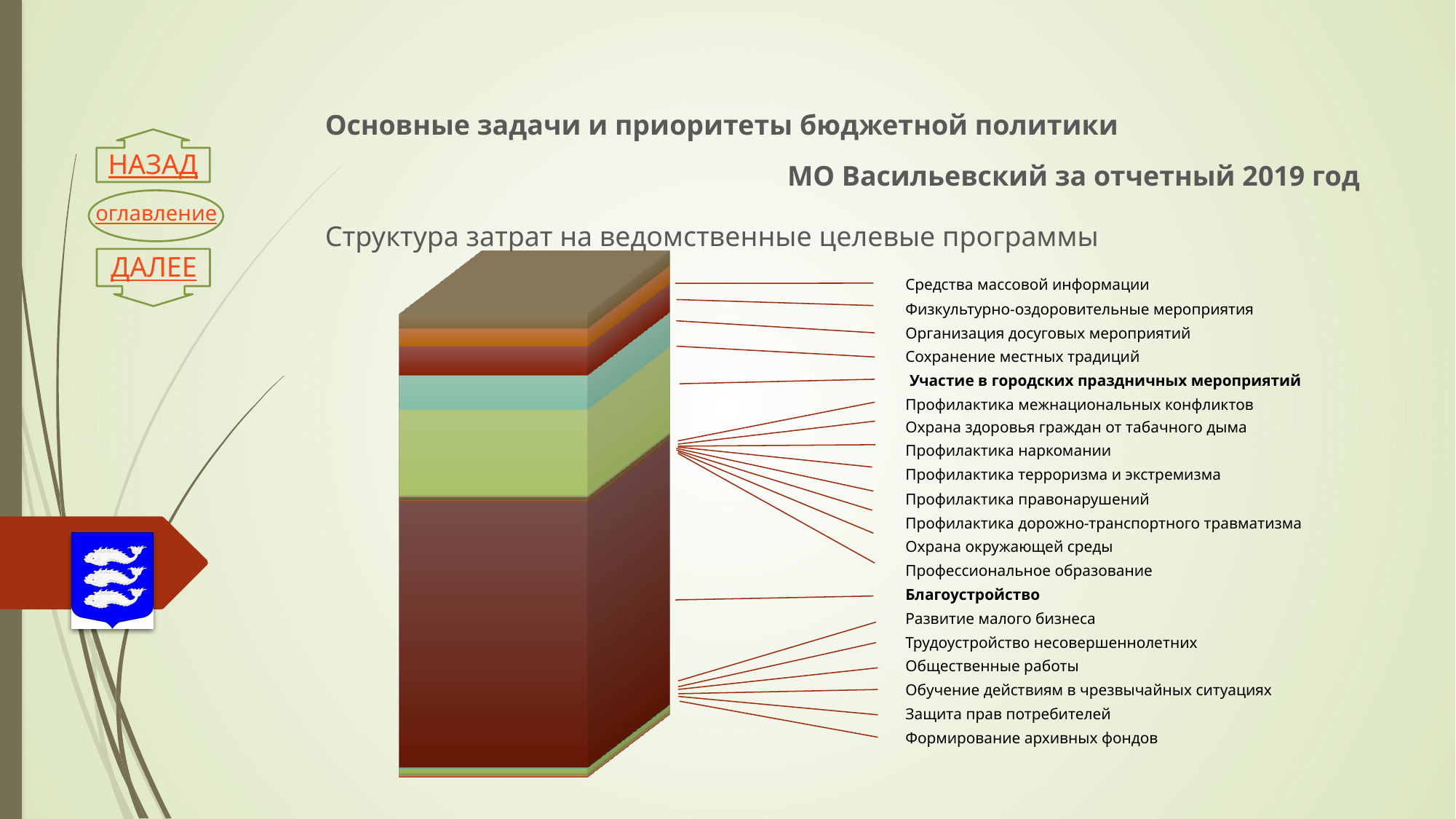
Which segment is larger: Участие в городских праздничных мероприятиях or Средства массовой информации? Участие в городских праздничных мероприятиях Which segment is larger: Благоустройство or Участие в городских праздничных мероприятиях? Благоустройство Which two category labels next to the chart are printed in bold? Участие в городских праздничных мероприятиях and Благоустройство Which category occupies the largest segment of the stacked bar? Благоустройство How many categories (programme labels) are listed next to the stacked bar? 20 Which segment is larger: Благоустройство or Средства массовой информации? Благоустройство What kind of chart is shown on the slide? stacked bar chart What is the title of the chart on the slide? Структура затрат на ведомственные целевые программы